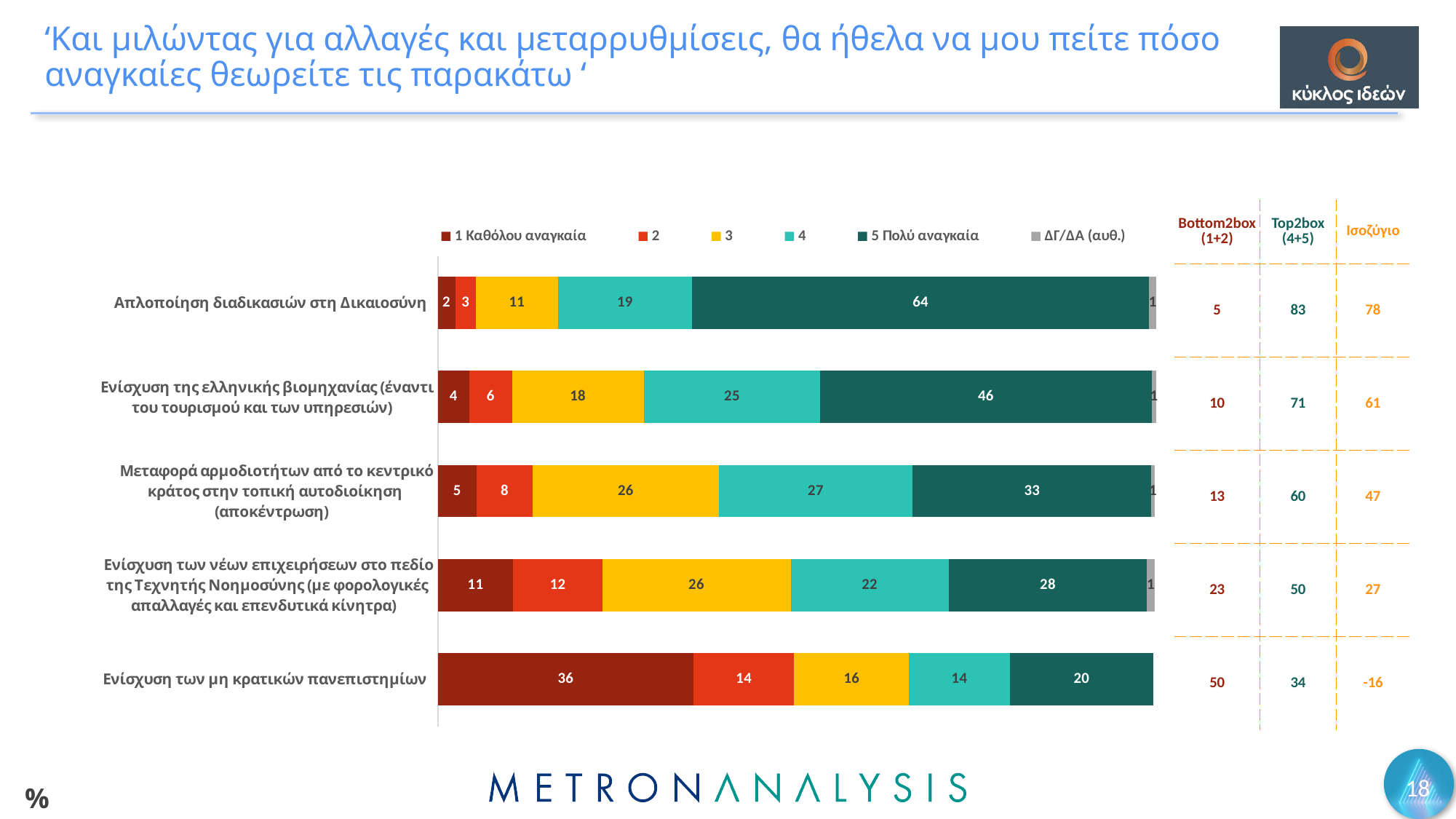
What is the total of the stacked bar for 'Ενίσχυση των μη κρατικών πανεπιστημίων'? 100 What is the value of the '3' segment for 'Μεταφορά αρμοδιοτήτων από το κεντρικό κράτος στην τοπική αυτοδιοίκηση (αποκέντρωση)'? 26 What is the value of the '5 Πολύ αναγκαία' segment for 'Απλοποίηση διαδικασιών στη Δικαιοσύνη'? 64 How many categories (rows) does the chart show? 5 What is the difference between the '4' segment values for 'Ενίσχυση της ελληνικής βιομηχανίας' and 'Απλοποίηση διαδικασιών στη Δικαιοσύνη'? 6 Which category has the lowest '5 Πολύ αναγκαία' value? Ενίσχυση των μη κρατικών πανεπιστημίων What is the value of the '1 Καθόλου αναγκαία' segment for 'Ενίσχυση των μη κρατικών πανεπιστημίων'? 36 What is the Ισοζύγιο value shown for 'Ενίσχυση των μη κρατικών πανεπιστημίων'? -16 Which is larger: the '2' segment for 'Ενίσχυση των νέων επιχειρήσεων στο πεδίο της Τεχνητής Νοημοσύνης' or the '2' segment for 'Μεταφορά αρμοδιοτήτων από το κεντρικό κράτος στην τοπική αυτοδιοίκηση'? Ενίσχυση των νέων επιχειρήσεων στο πεδίο της Τεχνητής Νοημοσύνης What kind of chart is shown on the slide? Stacked bar chart How many series does the legend list? 6 Which category has the highest '5 Πολύ αναγκαία' value? Απλοποίηση διαδικασιών στη Δικαιοσύνη